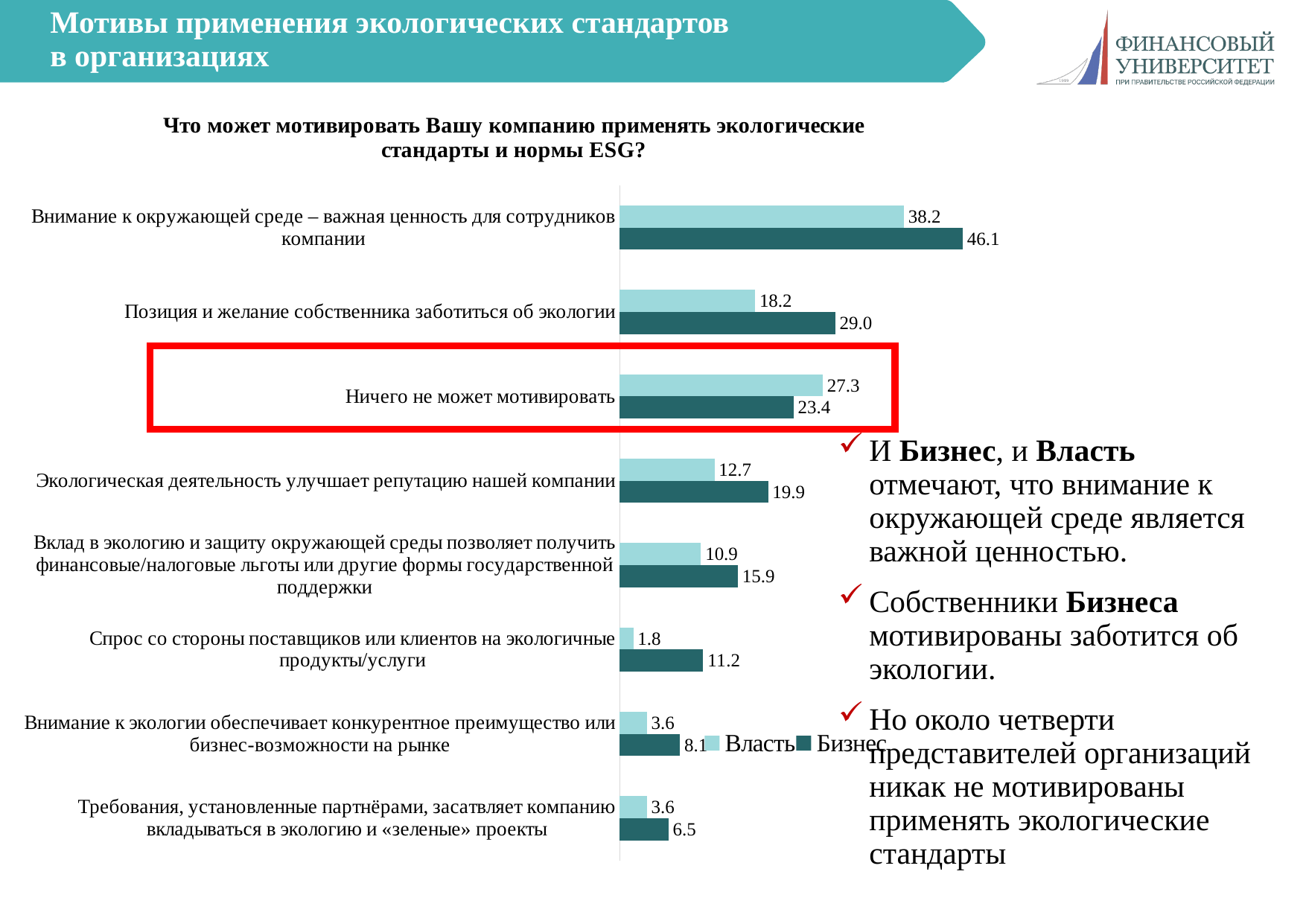
Which category is highlighted with a red box on the slide? Ничего не может мотивировать Which category has the highest value for the Власть series? Внимание к окружающей среде – важная ценность для сотрудников компании What is the value for Бизнес for "Спрос со стороны поставщиков или клиентов на экологичные продукты/услуги"? 11.2 How many series does the chart legend list? 2 What is the difference between the Бизнес and Власть values for "Экологическая деятельность улучшает репутацию нашей компании"? 7.2 What is the value for Бизнес for "Внимание к окружающей среде – важная ценность для сотрудников компании"? 46.1 For "Ничего не может мотивировать", which series has the larger value, Власть or Бизнес? Власть How many categories (motives) are shown in the chart? 8 What type of chart is shown on the slide? Bar chart Which category has the lowest value for the Бизнес series? Требования, установленные партнёрами, засатвляет компанию вкладываться в экологию и «зеленые» проекты What is the difference between the Бизнес and Власть values for "Позиция и желание собственника заботиться об экологии"? 10.8 What is the value for Власть for "Ничего не может мотивировать"? 27.3